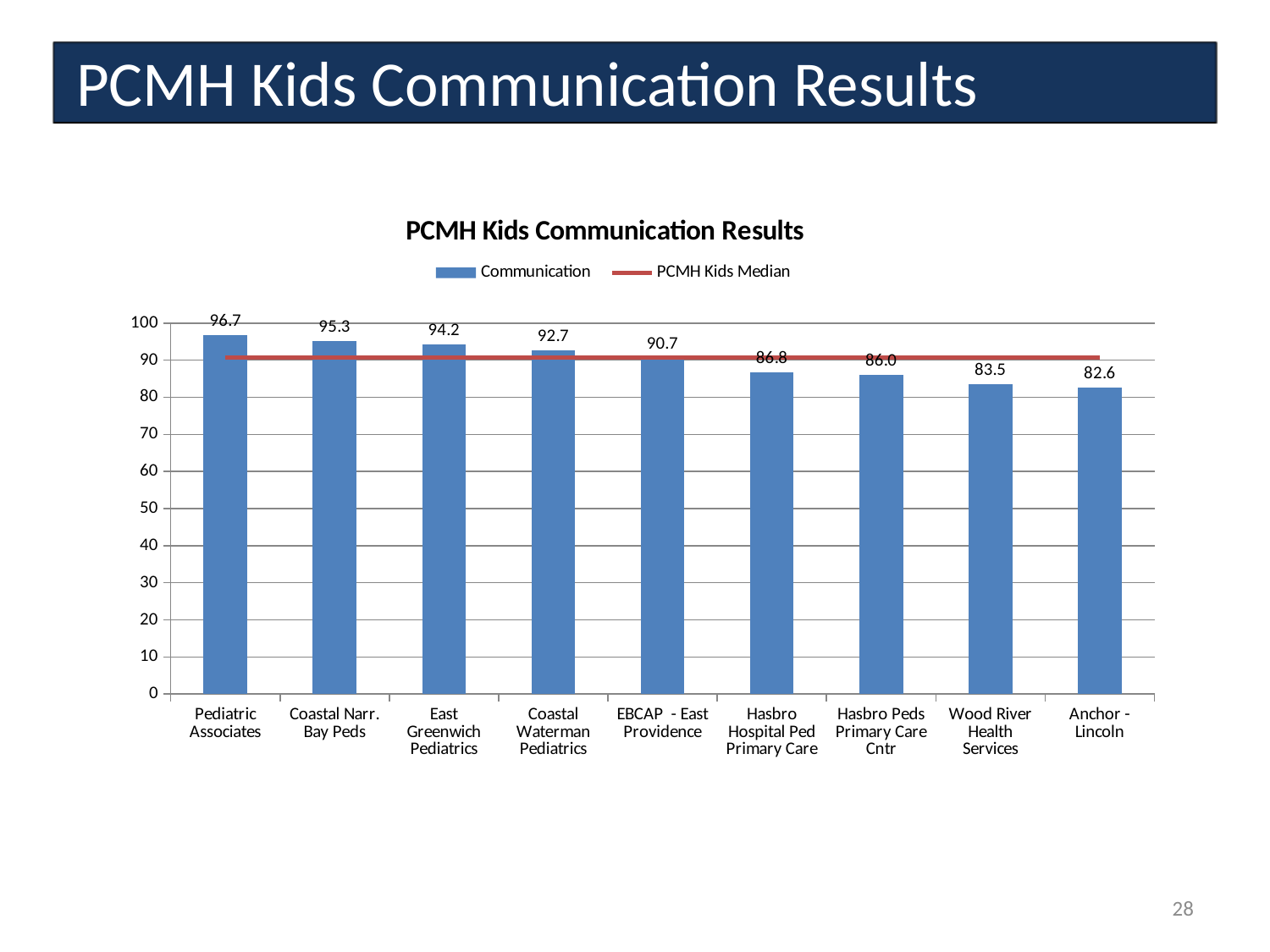
What is the Communication value for Wood River Health Services? 83.5 What is the Communication value for EBCAP - East Providence? 90.7 What is the difference between the Communication values for Coastal Narr. Bay Peds and Hasbro Peds Primary Care Cntr? 9.3 What kind of chart is used to show the Communication values? bar chart Which has a higher Communication value, East Greenwich Pediatrics or Coastal Waterman Pediatrics? East Greenwich Pediatrics Which practice has the highest Communication value? Pediatric Associates How many practices are shown on the x axis? 9 Which practice has the lowest Communication value? Anchor - Lincoln What is the Communication value for Pediatric Associates? 96.7 How many series does the legend list? 2 Do the Communication values rise or fall from left to right along the x axis? fall